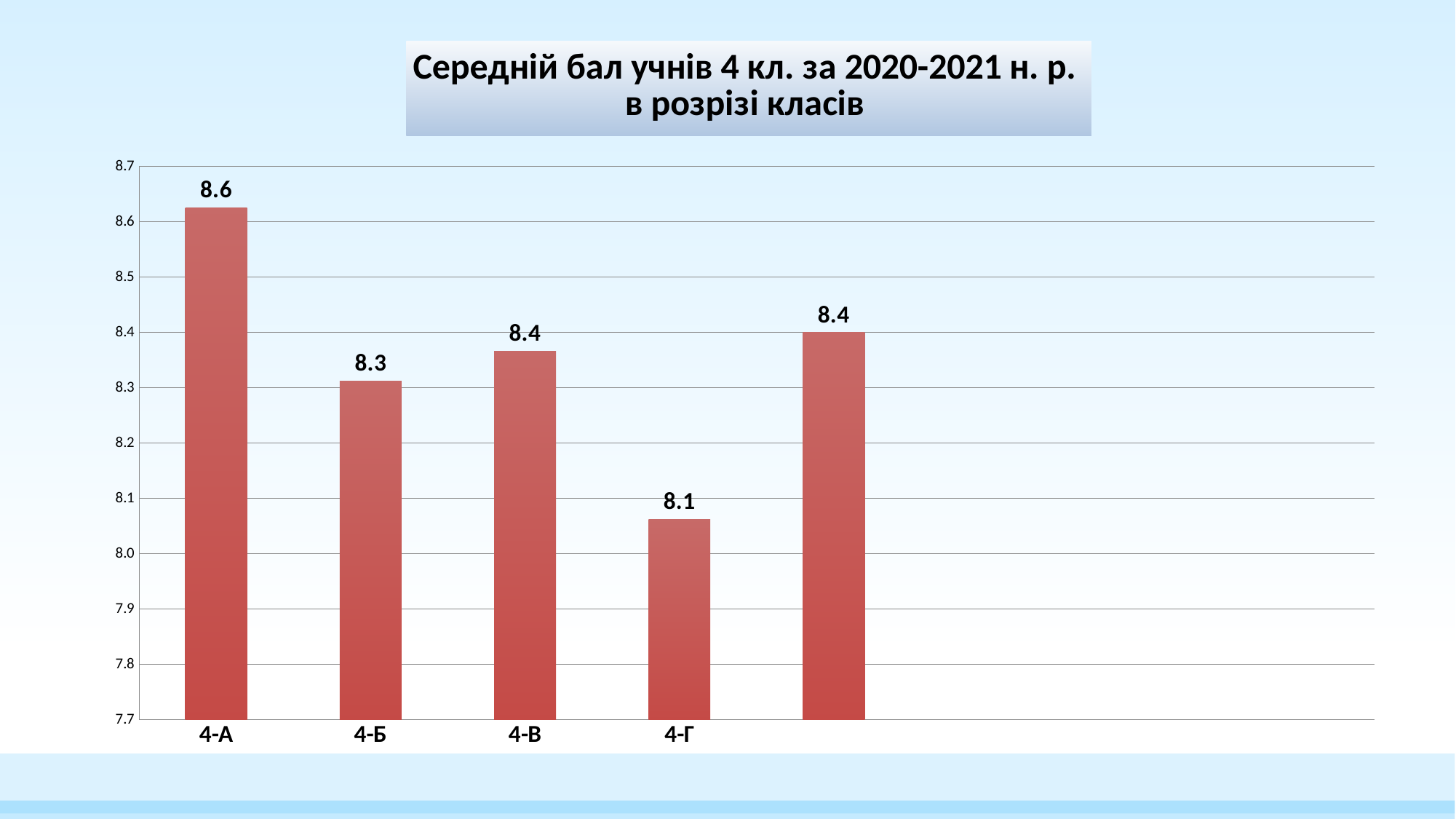
What is the value for 4-Г? 8.1 Which class has the lowest average score? 4-Г What is the value for 4-Б? 8.3 What is the difference between the values for 4-А and 4-Г? 0.5 Is the value for 4-Г greater or less than 8.2? less What is the value for 4-А? 8.6 What is the value for 4-В? 8.4 How many bars are plotted on the chart? 5 Which is larger, the value for 4-Б or the value for 4-В? 4-В What kind of chart is shown on the slide? bar chart Which labelled class has the highest average score? 4-А Is the value for 4-А greater or less than 8.5? greater